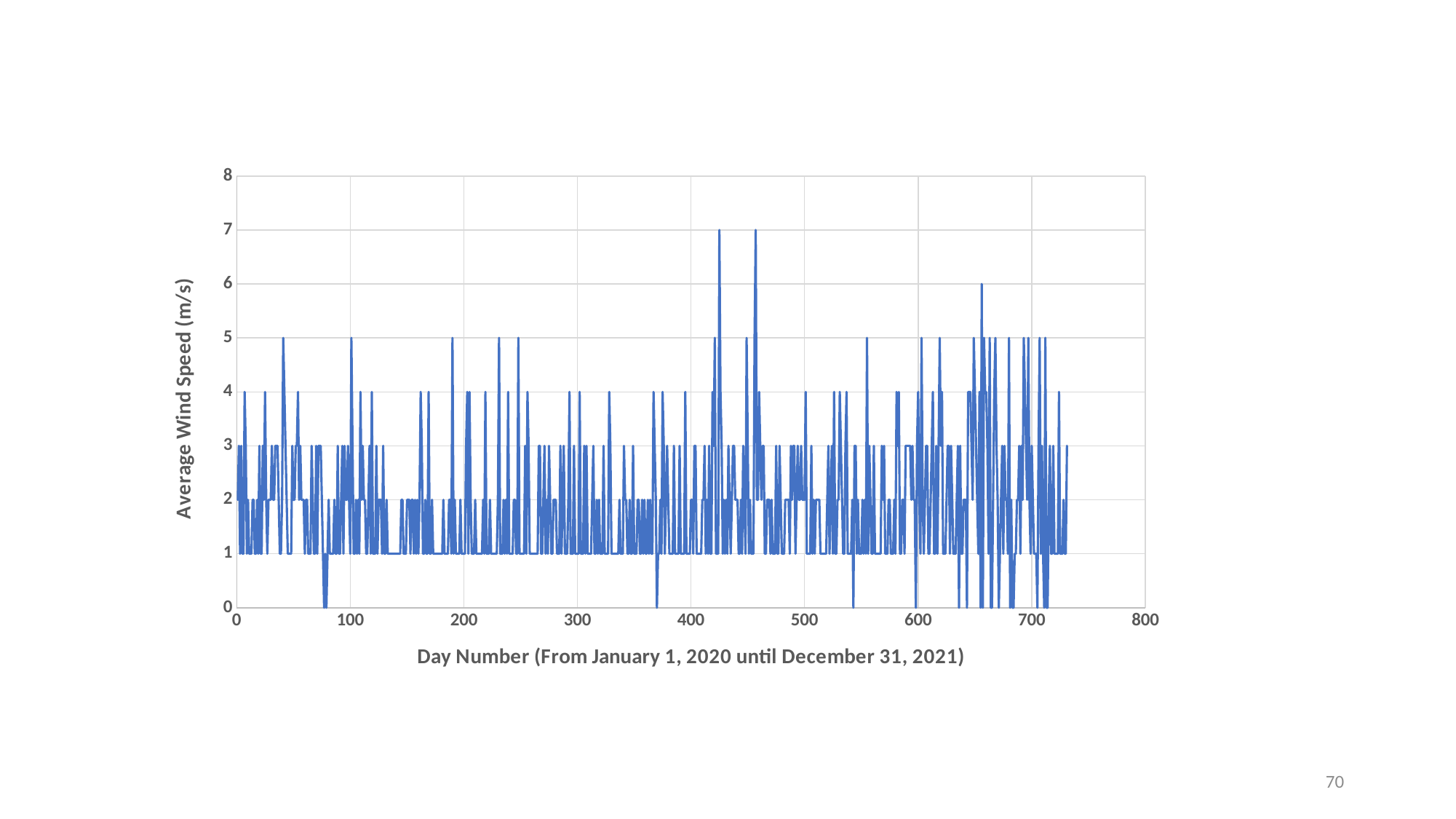
How many lines (data series) are plotted on the chart? 1 What is the highest tick value shown on the vertical axis? 8 What is the lowest average wind speed reached by the line? 0 Does the average wind speed show a clear rising or falling trend across the day numbers? no clear trend What is the title of the horizontal axis? Day Number (From January 1, 2020 until December 31, 2021) Is the peak value near day 40 greater or less than 6? less Is the peak value near day 655 greater or less than 5? greater What is the title of the vertical axis? Average Wind Speed (m/s) What kind of chart is shown on the slide? line chart Is the peak value near day 425 greater or less than 6? greater What is the highest average wind speed reached by the line? 7